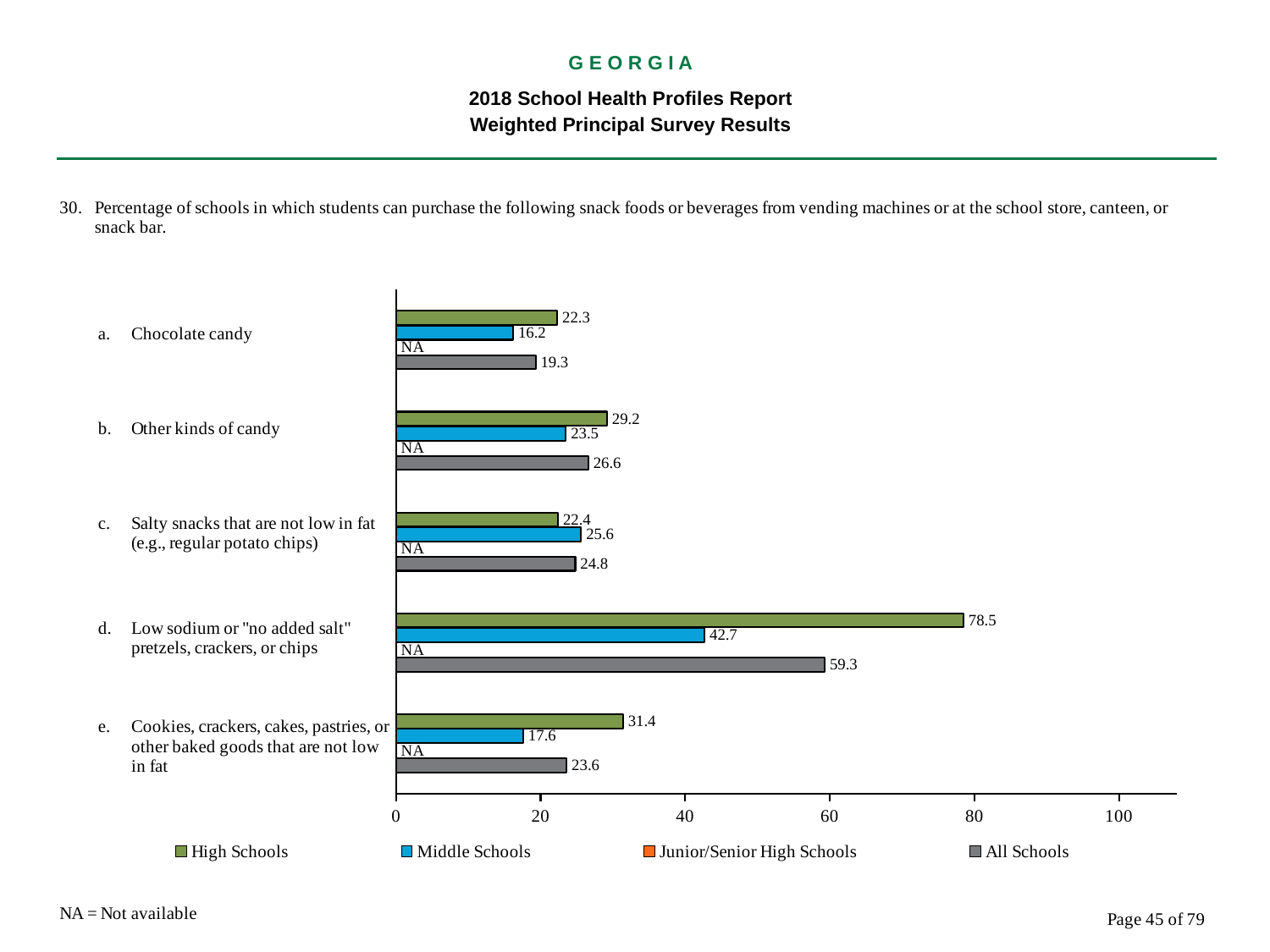
What value is shown for Junior/Senior High Schools in each category? NA How many snack food categories are shown on the chart? 5 What is the High Schools value for Chocolate candy? 22.3 Which is larger for Salty snacks that are not low in fat: the High Schools value or the Middle Schools value? Middle Schools What is the All Schools value for Cookies, crackers, cakes, pastries, or other baked goods that are not low in fat? 23.6 Is the All Schools value for Low sodium or "no added salt" pretzels, crackers, or chips greater or less than 40? greater What is the difference between the High Schools and Middle Schools values for Low sodium or "no added salt" pretzels, crackers, or chips? 35.8 Which category has the lowest Middle Schools value? Chocolate candy What is the Middle Schools value for Low sodium or "no added salt" pretzels, crackers, or chips? 42.7 Which category has the highest High Schools value? Low sodium or "no added salt" pretzels, crackers, or chips What kind of chart is shown on the slide? bar chart How many series does the legend list? 4